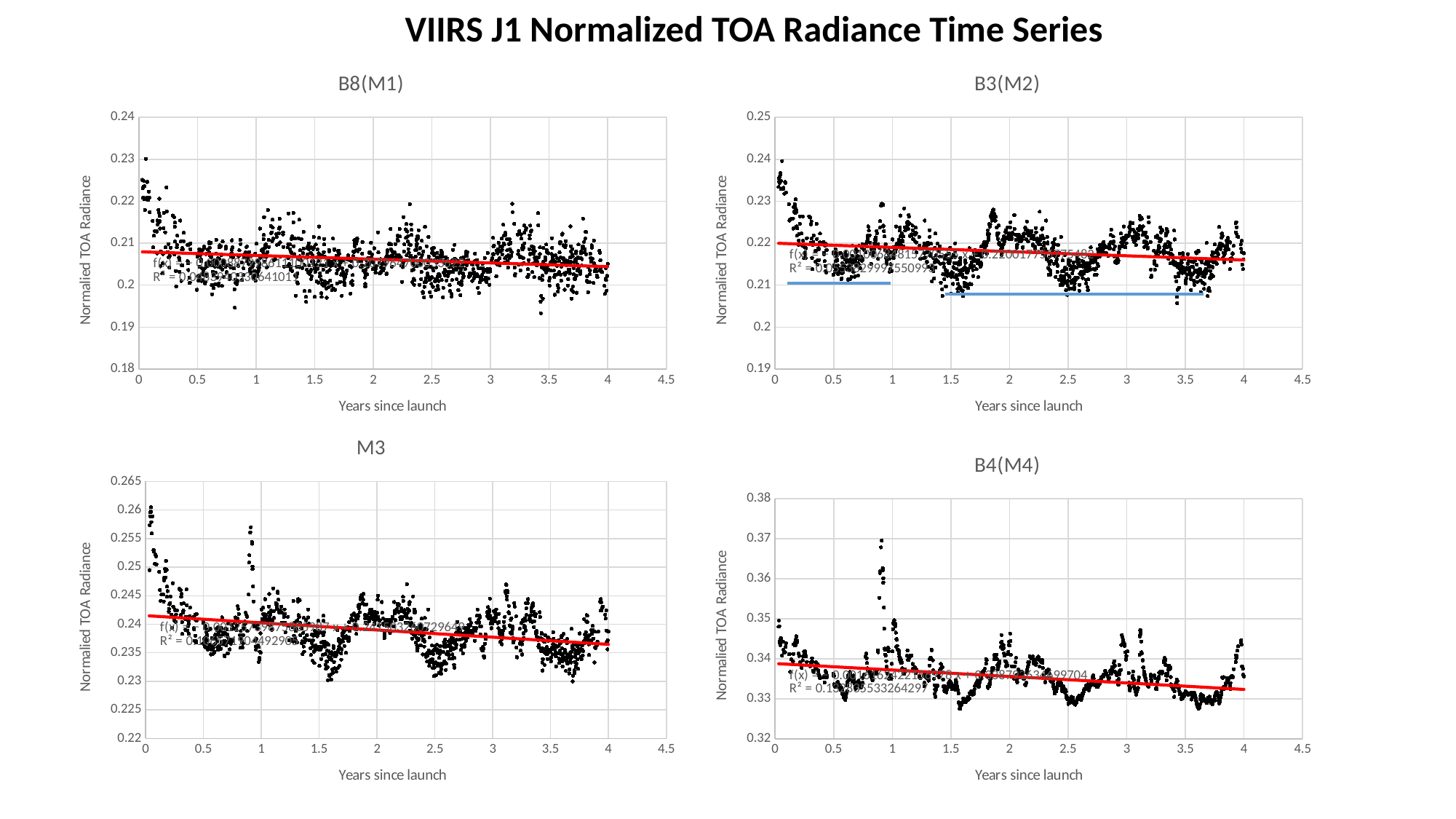
In the M3 chart, does the red trend line rise or fall along the x axis? fall What kind of chart is the B8(M1) chart? scatter chart In the B4(M4) chart, does the red trend line rise or fall along the x axis? fall In the M3 chart, is the lowest plotted point greater or less than 0.235? less In the M3 chart, is the highest plotted point greater or less than 0.255? greater What is the x-axis label of the B3(M2) chart? Years since launch In the B4(M4) chart, is the highest plotted point greater or less than 0.36? greater How many charts are shown on the slide? 4 In the B8(M1) chart, does the red trend line rise or fall along the x axis? fall What is the main title shown above the four charts? VIIRS J1 Normalized TOA Radiance Time Series